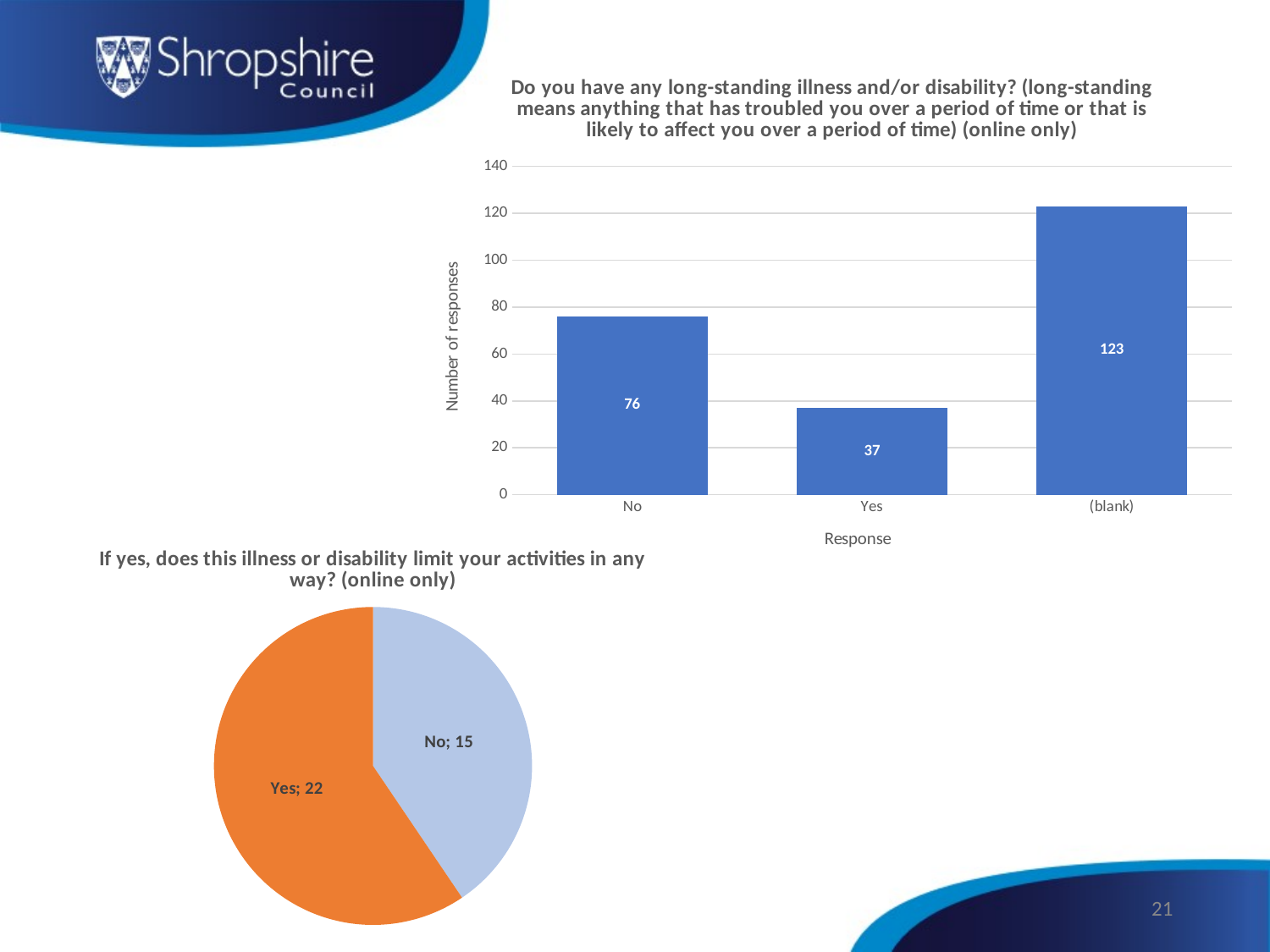
In the bar chart about long-standing illness and/or disability, how many response categories are shown on the x axis? 3 In the bar chart about long-standing illness and/or disability, which response category has the highest number of responses? (blank) In the bar chart about long-standing illness and/or disability, what is the difference between the number of responses for "No" and "Yes"? 39 In the bar chart about long-standing illness and/or disability, which response category has the lowest number of responses? Yes In the bar chart about long-standing illness and/or disability, what is the number of responses for "Yes"? 37 In the pie chart about whether the illness or disability limits activities, what is the value for "No"? 15 What kind of chart is the chart titled "If yes, does this illness or disability limit your activities in any way? (online only)"? Pie chart In the bar chart about long-standing illness and/or disability, what is the label of the y axis? Number of responses In the bar chart about long-standing illness and/or disability, what is the number of responses for "No"? 76 In the pie chart about whether the illness or disability limits activities, what is the value for "Yes"? 22 In the bar chart about long-standing illness and/or disability, what is the number of responses for "(blank)"? 123 In the pie chart about whether the illness or disability limits activities, which slice is larger, "Yes" or "No"? Yes